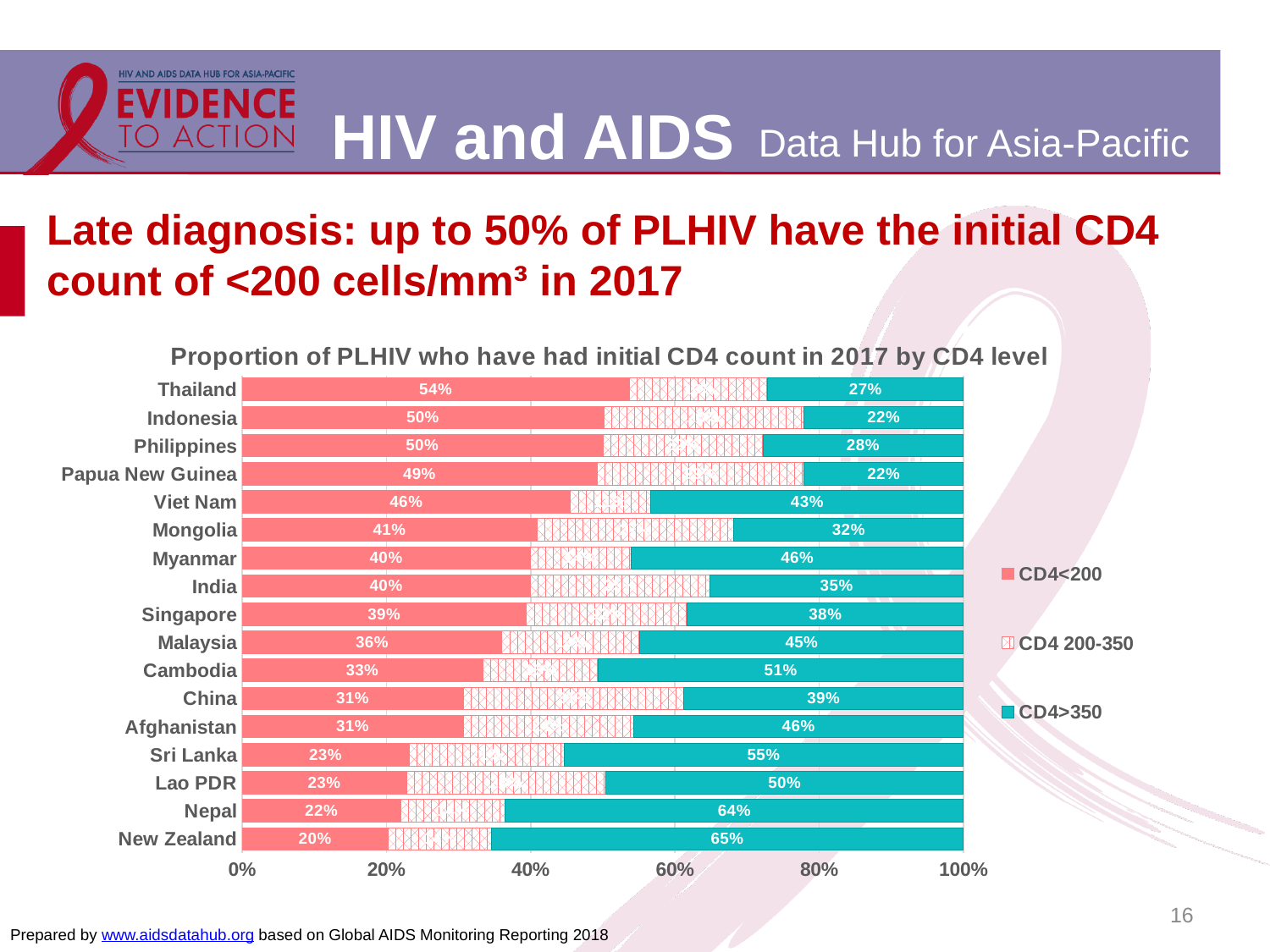
What is the CD4<200 value for Thailand? 54% What is the CD4<200 value for New Zealand? 20% How many countries are shown in the chart? 17 What is the difference between the CD4<200 values for Thailand and New Zealand? 34% How many series does the legend list? 3 What kind of chart is shown on the slide? Stacked bar chart Which has the larger CD4>350 value, Viet Nam or Mongolia? Viet Nam What is the CD4>350 value for Nepal? 64% What is the title of the chart? Proportion of PLHIV who have had initial CD4 count in 2017 by CD4 level Which country has the lowest CD4<200 proportion? New Zealand Which country has the highest CD4<200 proportion? Thailand What is the CD4>350 value for Cambodia? 51%